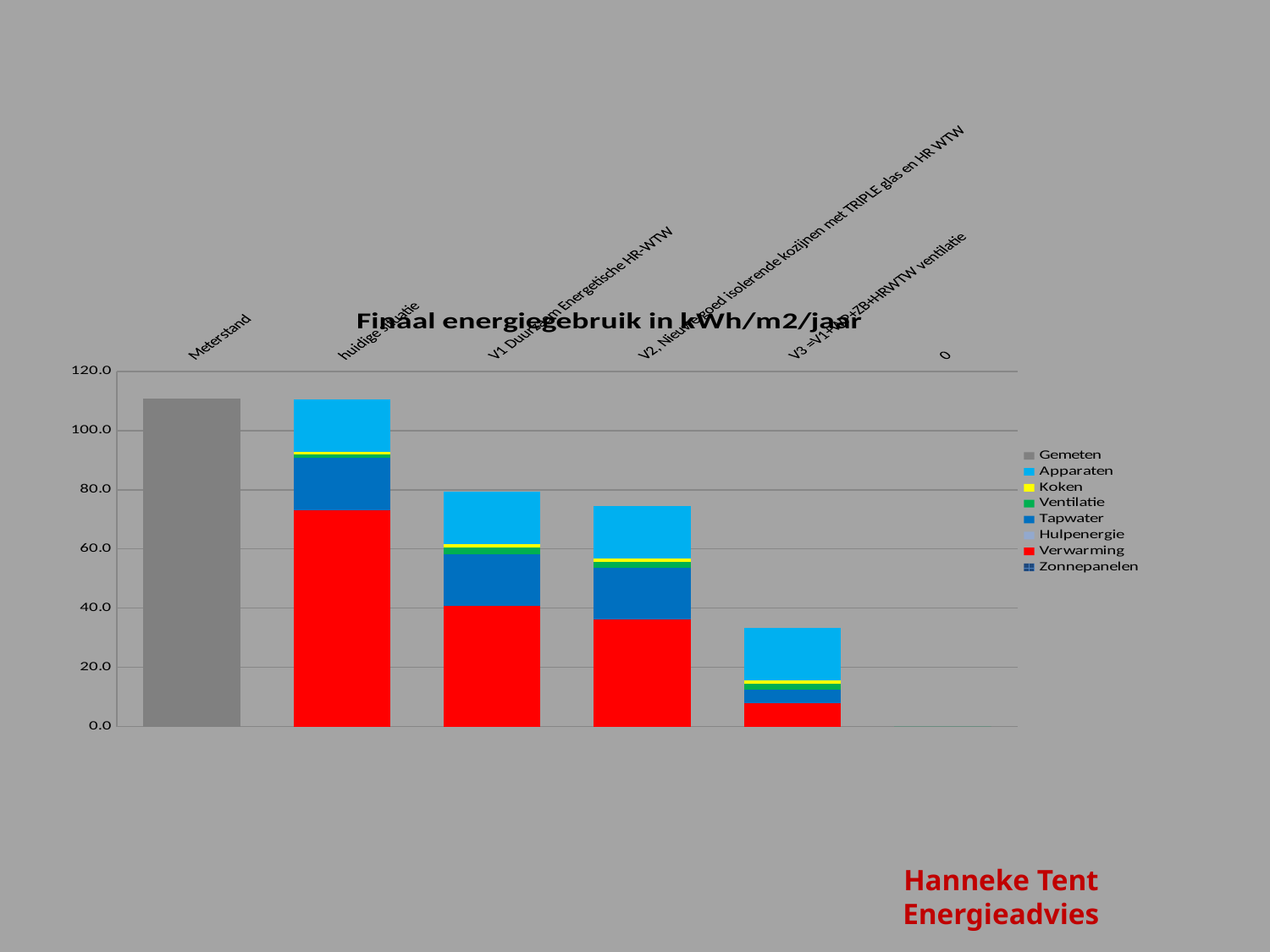
Which bar is taller, V1 or V3? V1 Among the scenario bars V1, V2 and V3, which has the lowest total? V3 Is the total of the V1 bar greater or less than 60? greater Is the total of the V2 bar greater or less than 80? less Is the value for Meterstand greater or less than 100? greater What kind of chart is shown on the slide? stacked bar chart Do the bar totals generally rise or fall from left to right across the chart? fall What is the title of the chart? Finaal energiegebruik in kWh/m2/jaar Which colour represents the Verwarming series in the chart? red How many series does the legend list? 8